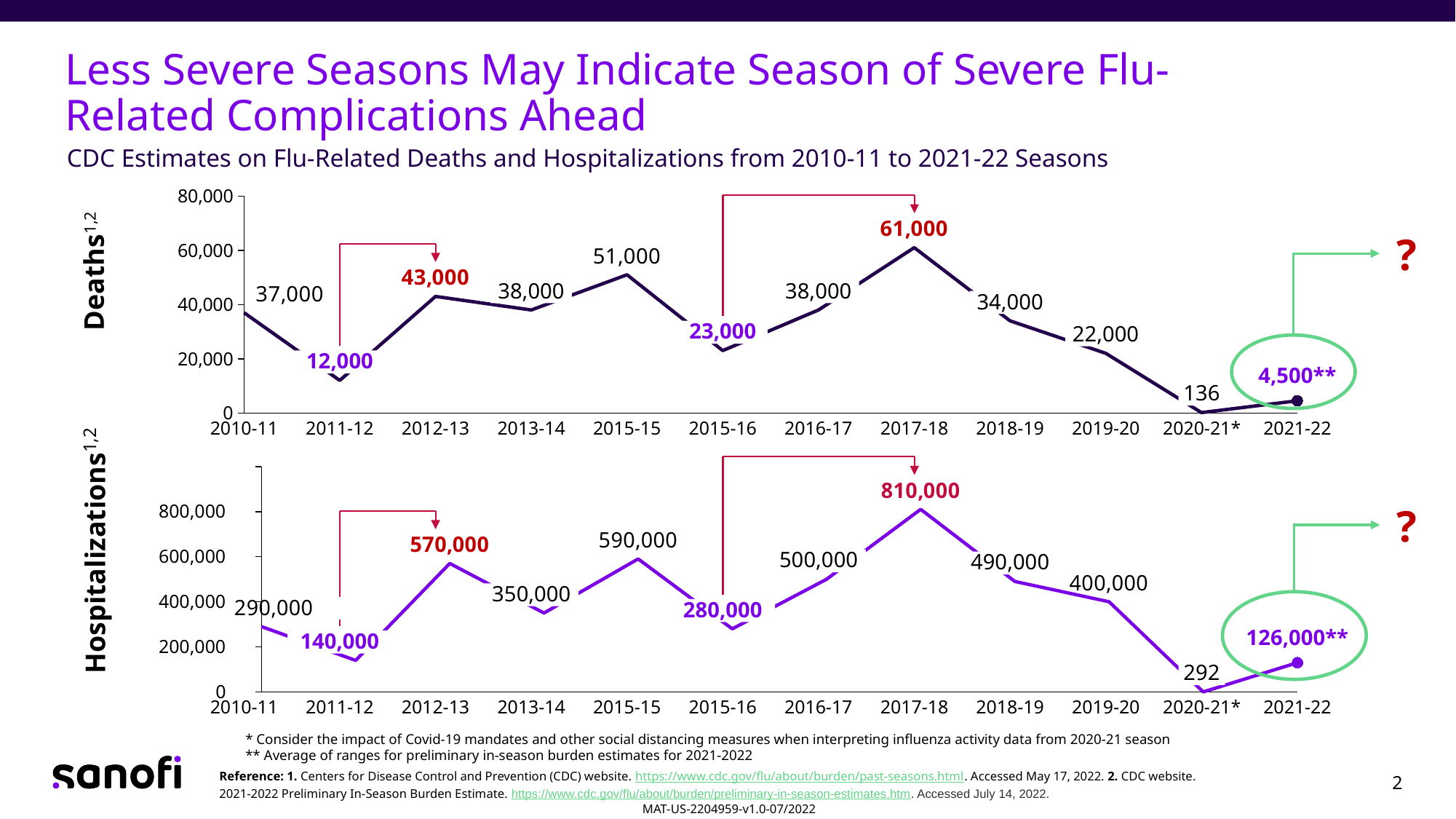
In the Deaths chart, what is the value for the 2017-18 season? 61,000 In the Hospitalizations chart, what is the difference between the 2017-18 value and the 2015-16 value? 530,000 In the Hospitalizations chart, do the values rise or fall from 2017-18 to 2020-21*? Fall In the Deaths chart, which season has the lowest value? 2020-21* In the Hospitalizations chart, what is the value for the 2021-22 season? 126,000** In the Hospitalizations chart, which season has the highest value? 2017-18 In the Hospitalizations chart, what is the value for the 2012-13 season? 570,000 What type of chart is the Deaths chart? Line chart In the Deaths chart, what is the difference between the 2012-13 value and the 2011-12 value? 31,000 In the Deaths chart, which is larger, the value for 2013-14 or the value for 2018-19? 2013-14 How many seasons are plotted on the x axis of the Hospitalizations chart? 12 In the Deaths chart, what is the value for the 2020-21* season? 136